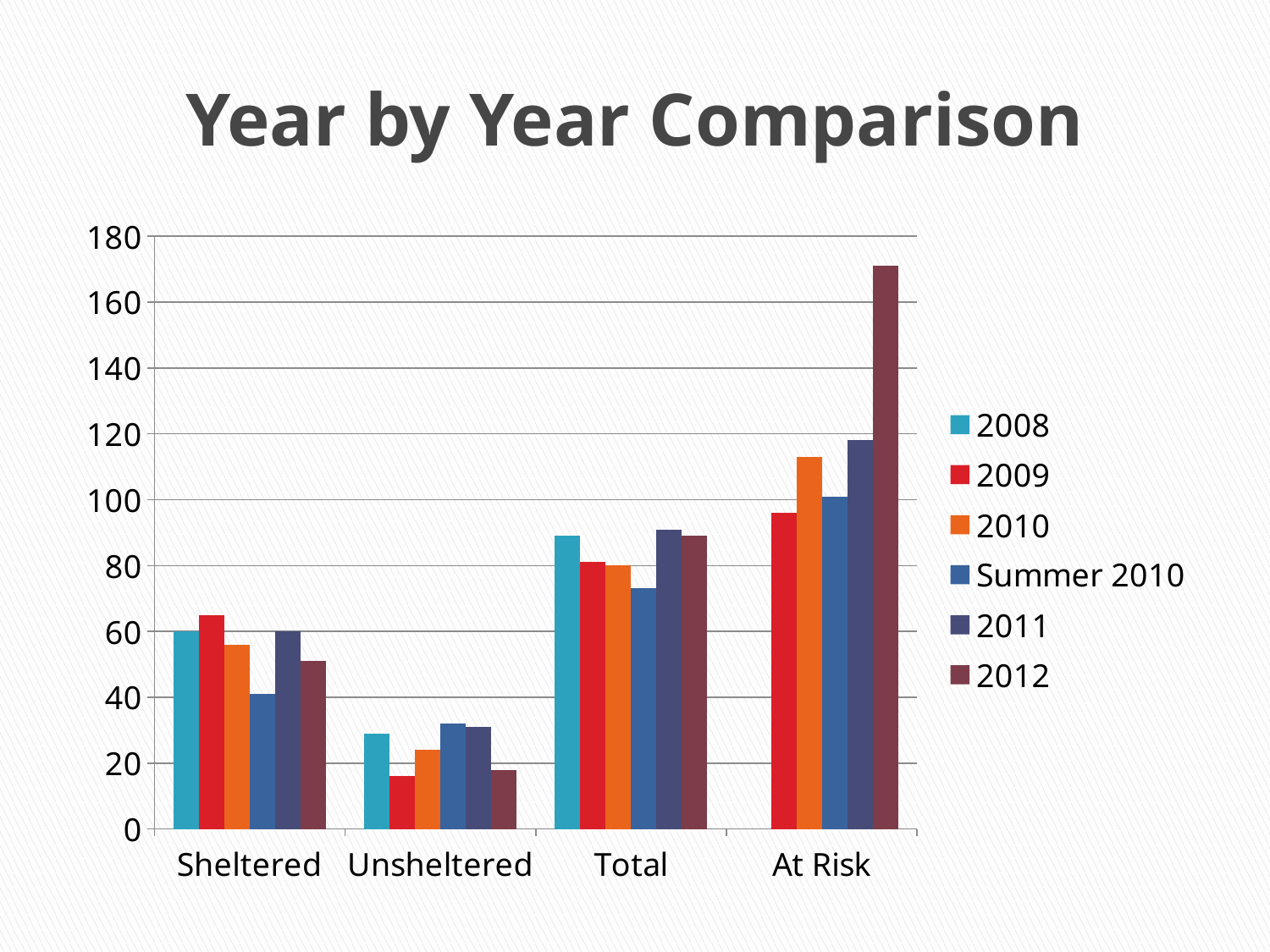
In the At Risk category, which series has the highest bar? 2012 Is the value for 2012 in the At Risk category greater or less than 160? greater Is the value for 2011 in the Total category greater or less than 80? greater In the Sheltered category, which is larger: the 2009 bar or the 2012 bar? 2009 Is the value for 2009 in the Unsheltered category greater or less than 20? less In the Unsheltered category, which series has the lowest bar? 2009 What kind of chart is shown on the slide? bar chart What is the title of the chart? Year by Year Comparison How many series does the legend list? 6 In the Total category, which is larger: the 2008 bar or the Summer 2010 bar? 2008 How many categories are shown on the x axis? 4